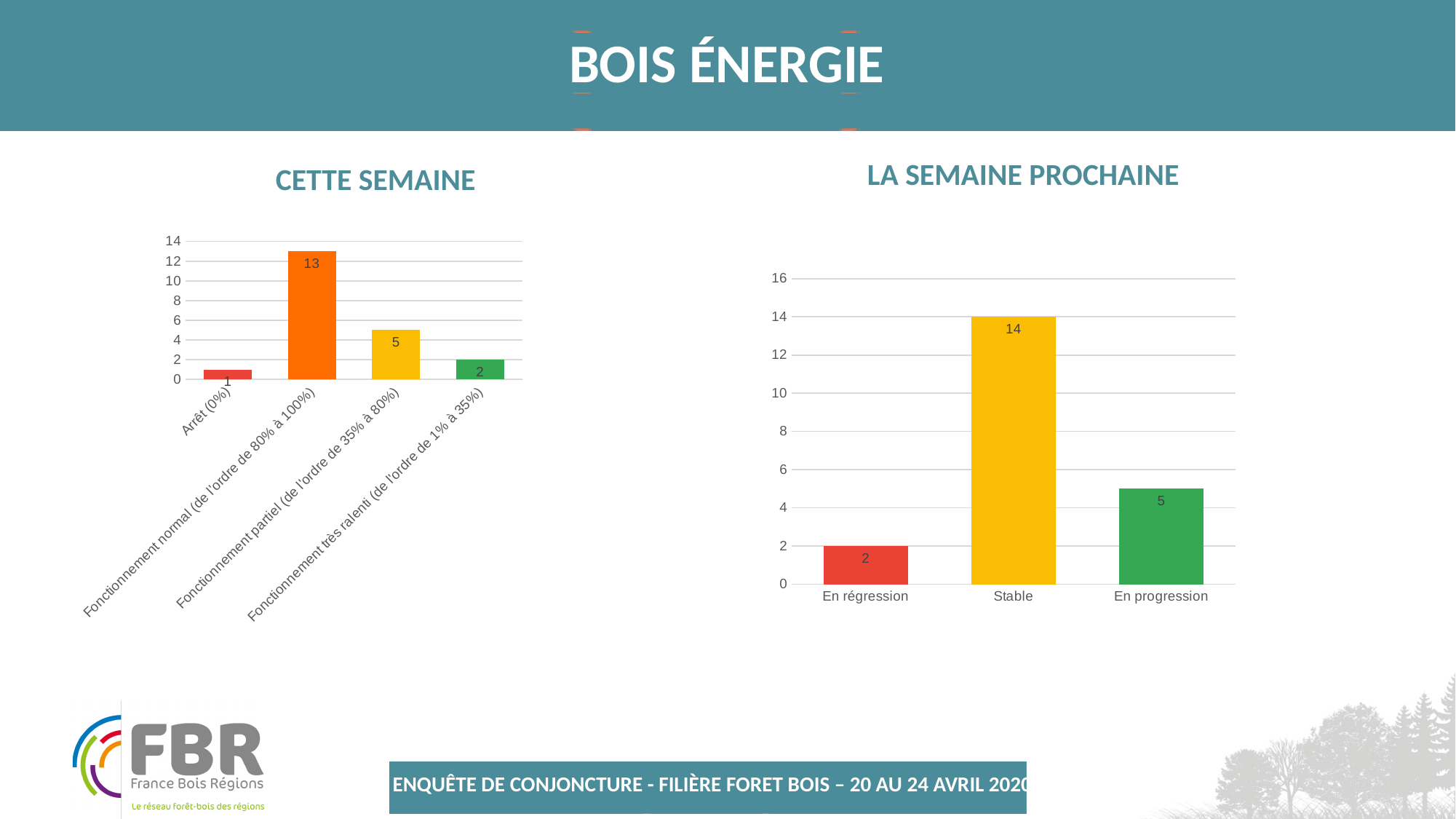
How many categories are shown in the 'CETTE SEMAINE' chart? 4 In the 'CETTE SEMAINE' chart, which category has the lowest value? Arrêt (0%) In the 'LA SEMAINE PROCHAINE' chart, which is larger: 'En progression' or 'En régression'? En progression In the 'CETTE SEMAINE' chart, which category has the highest value? Fonctionnement normal (de l'ordre de 80% à 100%) In the 'LA SEMAINE PROCHAINE' chart, what is the difference between 'Stable' and 'En régression'? 12 In the 'CETTE SEMAINE' chart, what is the difference between 'Fonctionnement partiel (de l'ordre de 35% à 80%)' and 'Fonctionnement très ralenti (de l'ordre de 1% à 35%)'? 3 In the 'CETTE SEMAINE' chart, what is the value for 'Fonctionnement normal (de l'ordre de 80% à 100%)'? 13 In the 'LA SEMAINE PROCHAINE' chart, which category has the lowest value? En régression What type of chart is the 'LA SEMAINE PROCHAINE' chart? Bar chart In the 'LA SEMAINE PROCHAINE' chart, what is the value for 'En progression'? 5 In the 'CETTE SEMAINE' chart, what is the value for 'Arrêt (0%)'? 1 In the 'LA SEMAINE PROCHAINE' chart, what is the value for 'Stable'? 14